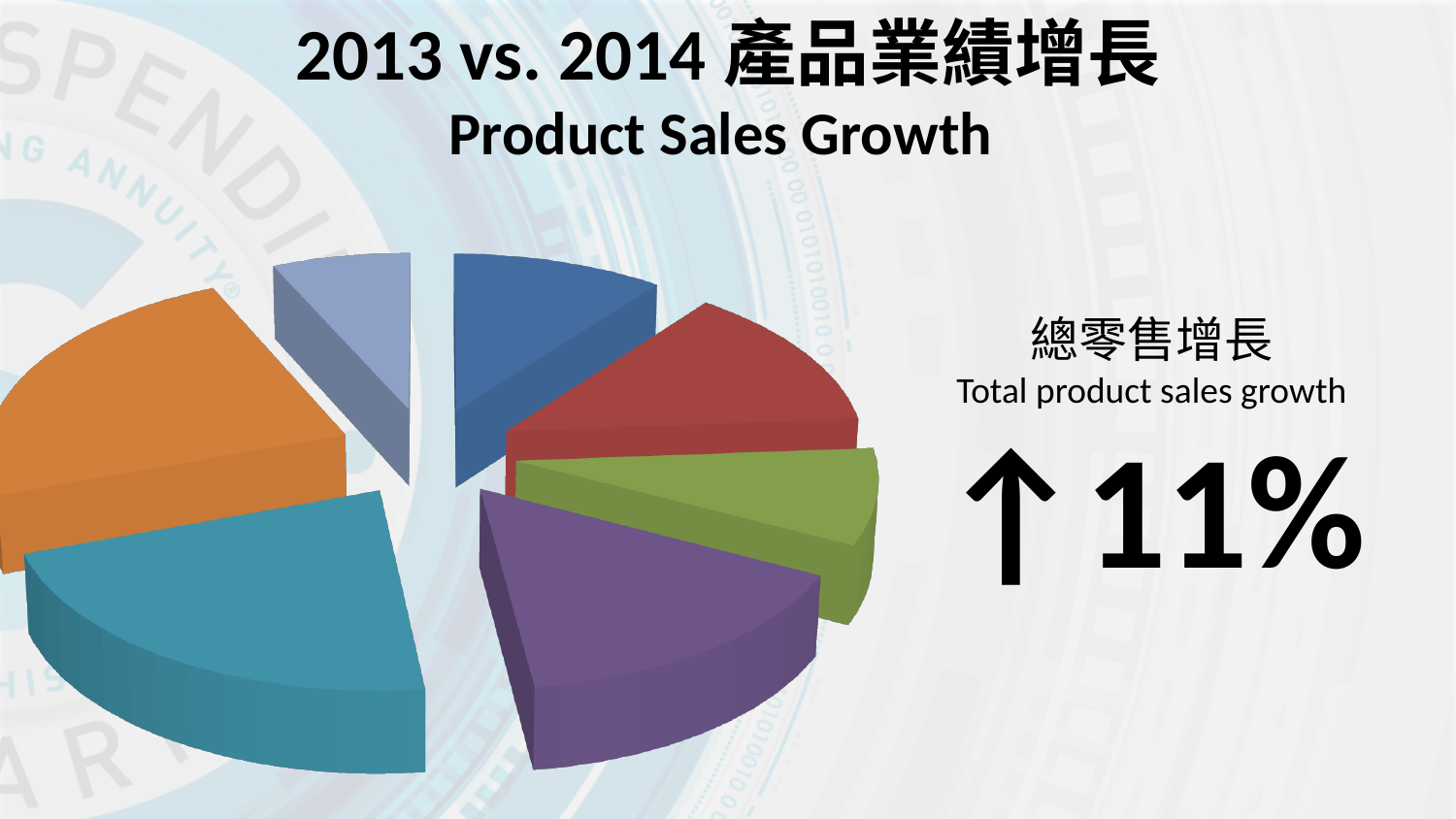
What total product sales growth figure is shown next to the pie chart? ↑11% What kind of chart is shown on the slide? pie chart Which is larger in the pie chart, the orange slice or the dark blue slice? orange How many slices does the pie chart have? 7 Which is larger in the pie chart, the teal slice or the purple slice? teal What is the English title of the chart on the slide? Product Sales Growth Which is larger in the pie chart, the teal slice or the red slice? teal